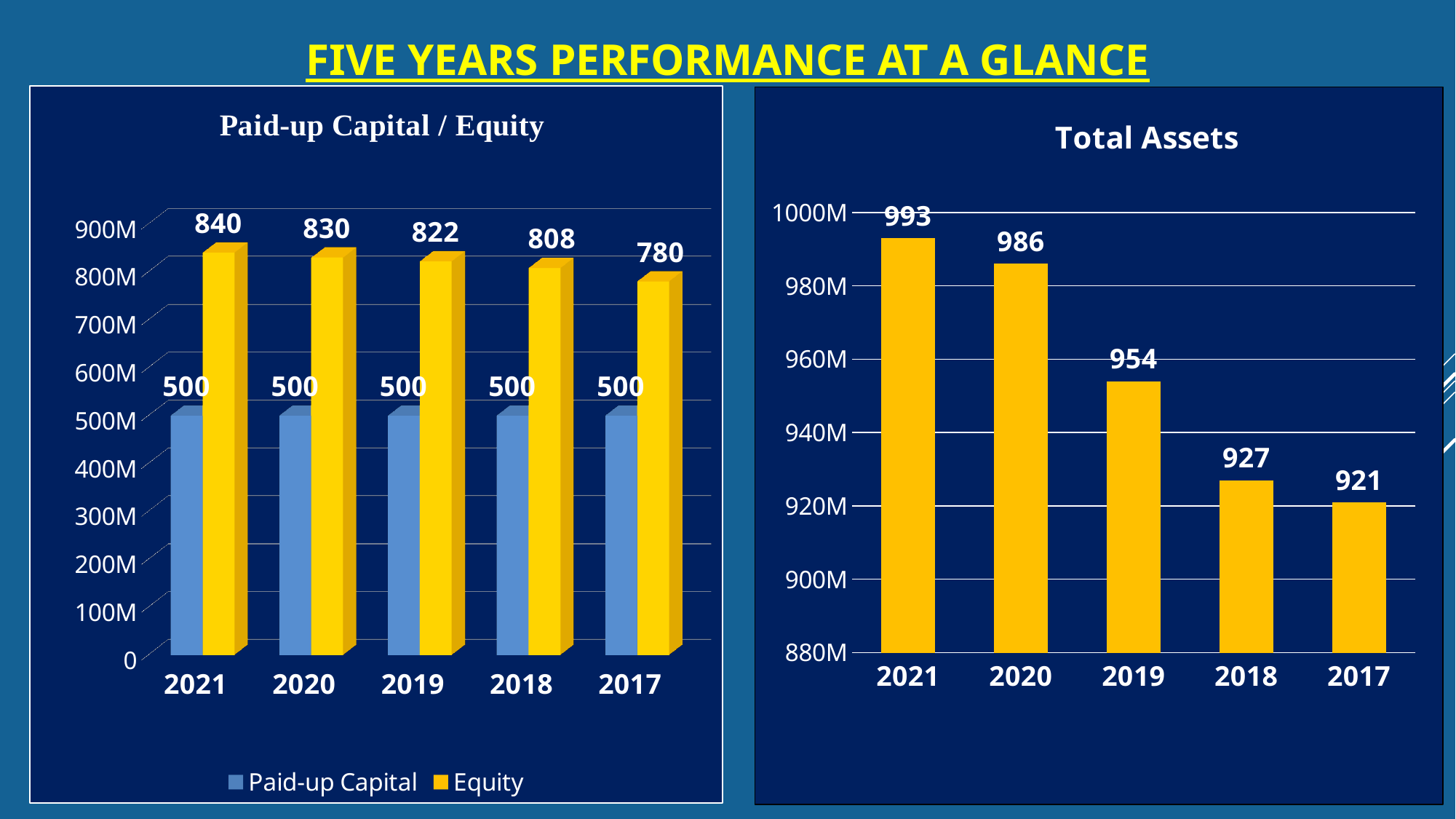
In the Total Assets chart, what is the difference between the values for 2020 and 2018? 59 In the Paid-up Capital / Equity chart, does the Equity value rise or fall going from 2021 to 2017 along the x axis? fall In the Paid-up Capital / Equity chart, which year has the lowest Equity value? 2017 In the Total Assets chart, what is the value for 2019? 954 What kind of chart is the Total Assets chart? bar chart In the Paid-up Capital / Equity chart, what is the Equity value for 2021? 840 In the Paid-up Capital / Equity chart, what is the difference between the Equity values for 2021 and 2017? 60 In the Paid-up Capital / Equity chart, how many series does the legend list? 2 In the Paid-up Capital / Equity chart, what is the Paid-up Capital value for 2019? 500 In the Total Assets chart, which is larger, the value for 2018 or the value for 2017? 2018 In the Total Assets chart, which year has the highest value? 2021 In the Total Assets chart, how many years are plotted? 5